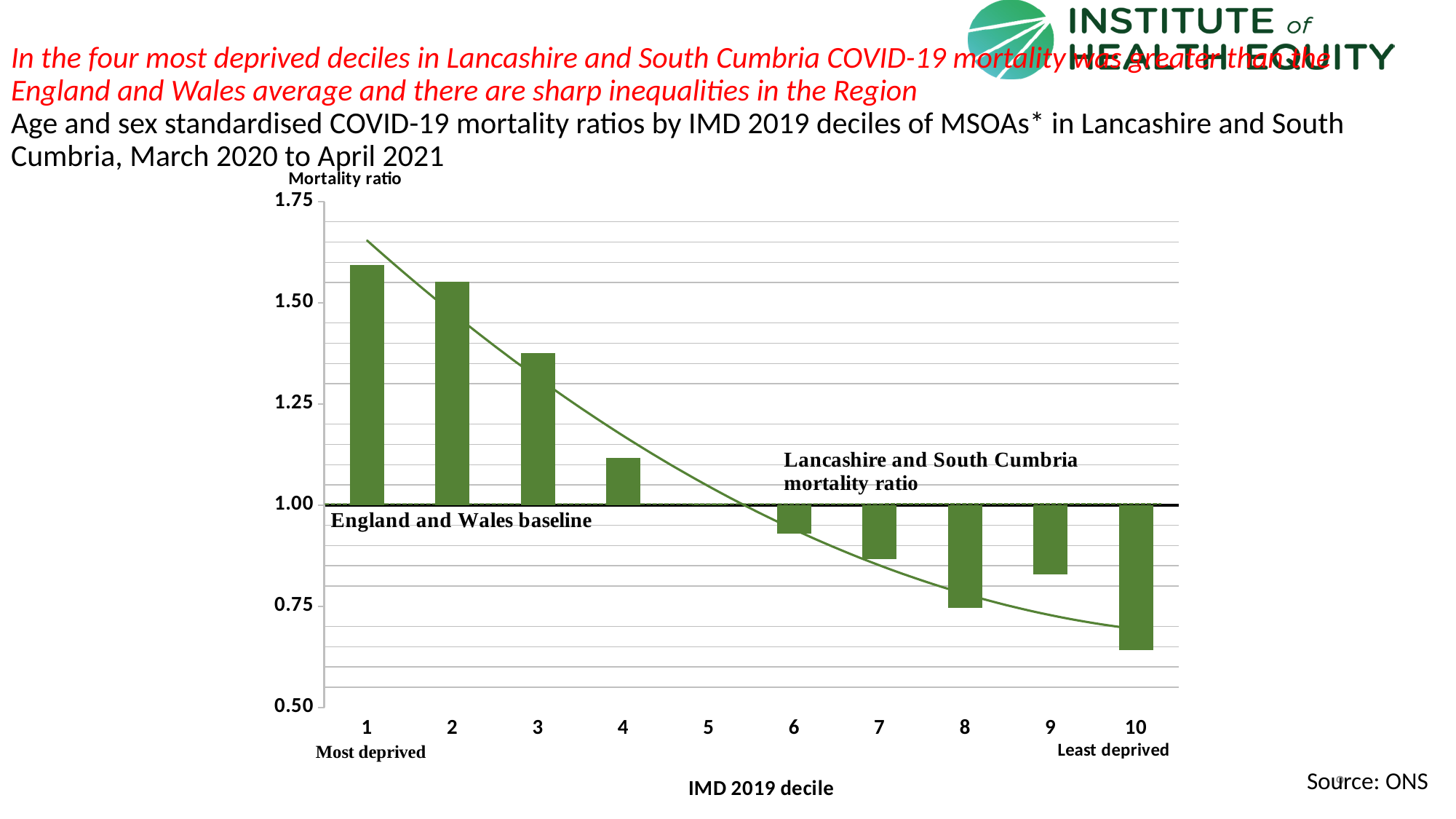
Is the mortality ratio for decile 10 greater or less than 0.75? less Which has the higher mortality ratio, decile 8 or decile 9? Decile 9 Which IMD 2019 decile has the lowest mortality ratio? 10 What kind of chart is shown on the slide? Bar chart Is the mortality ratio for decile 3 greater or less than 1.25? greater Do the mortality ratios generally rise or fall as the IMD 2019 decile increases from 1 to 10? Fall How many IMD 2019 deciles are shown on the x axis of the chart? 10 Which IMD 2019 decile has the highest mortality ratio? 1 Is the mortality ratio for decile 1 greater or less than 1.50? greater Which has the higher mortality ratio, decile 2 or decile 3? Decile 2 What value does the horizontal line labelled 'England and Wales baseline' sit at on the y axis? 1.00